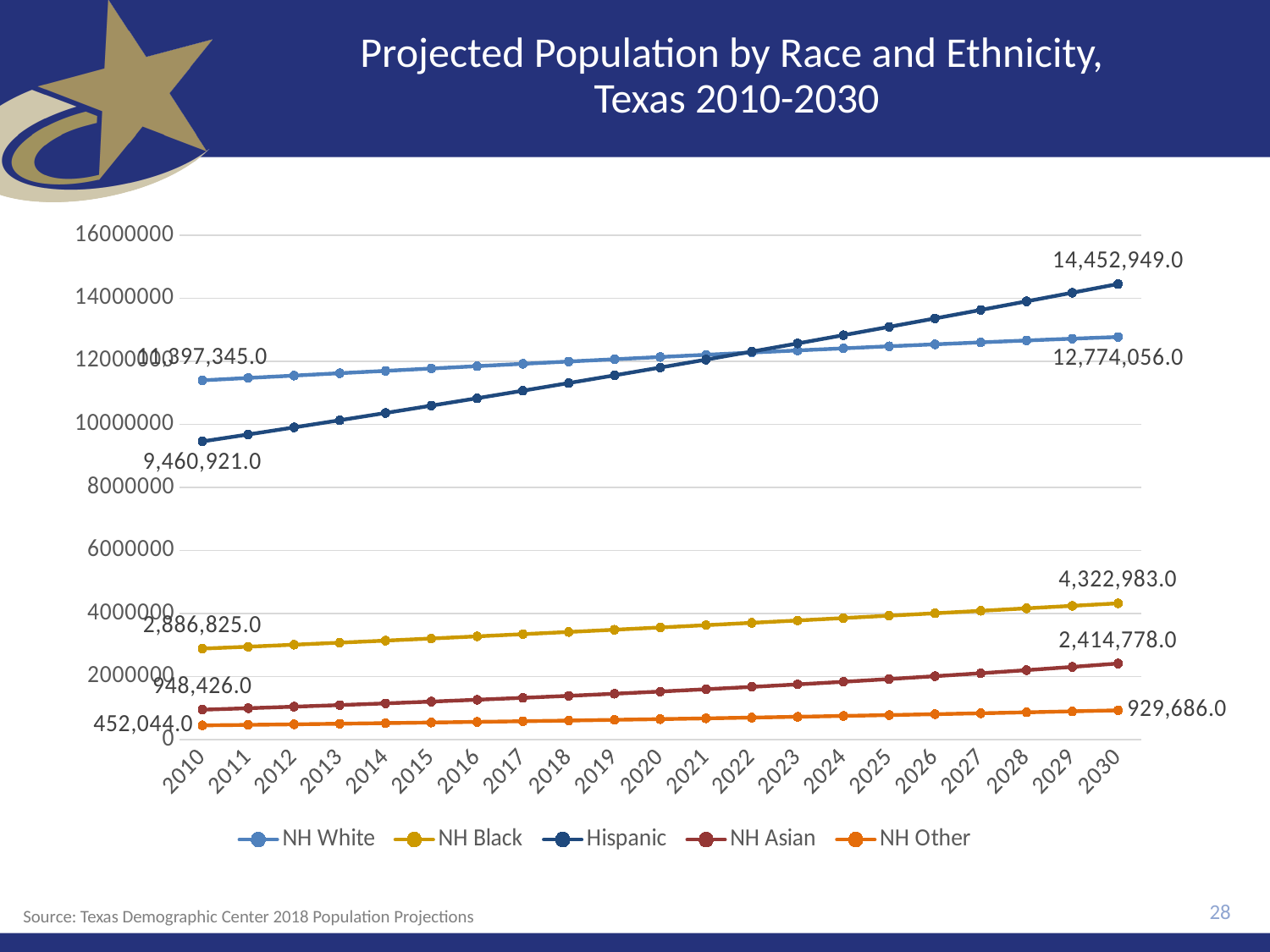
How many years are plotted along the x axis? 21 Is the NH Asian value for 2020 greater or less than 2000000? less How many series does the legend list? 5 What kind of chart is shown on the slide? line chart What is the projected Hispanic population in 2030? 14,452,949.0 What is the projected NH White population in 2030? 12,774,056.0 By how much does the Hispanic population increase from 2010 to 2030? 4,992,028.0 Which group has the lowest projected population in 2030? NH Other Which group has the highest projected population in 2030? Hispanic What is the NH Black population value shown for 2010? 2,886,825.0 In 2010, which is larger: the NH White population or the Hispanic population? NH White What is the NH Other population value shown for 2030? 929,686.0